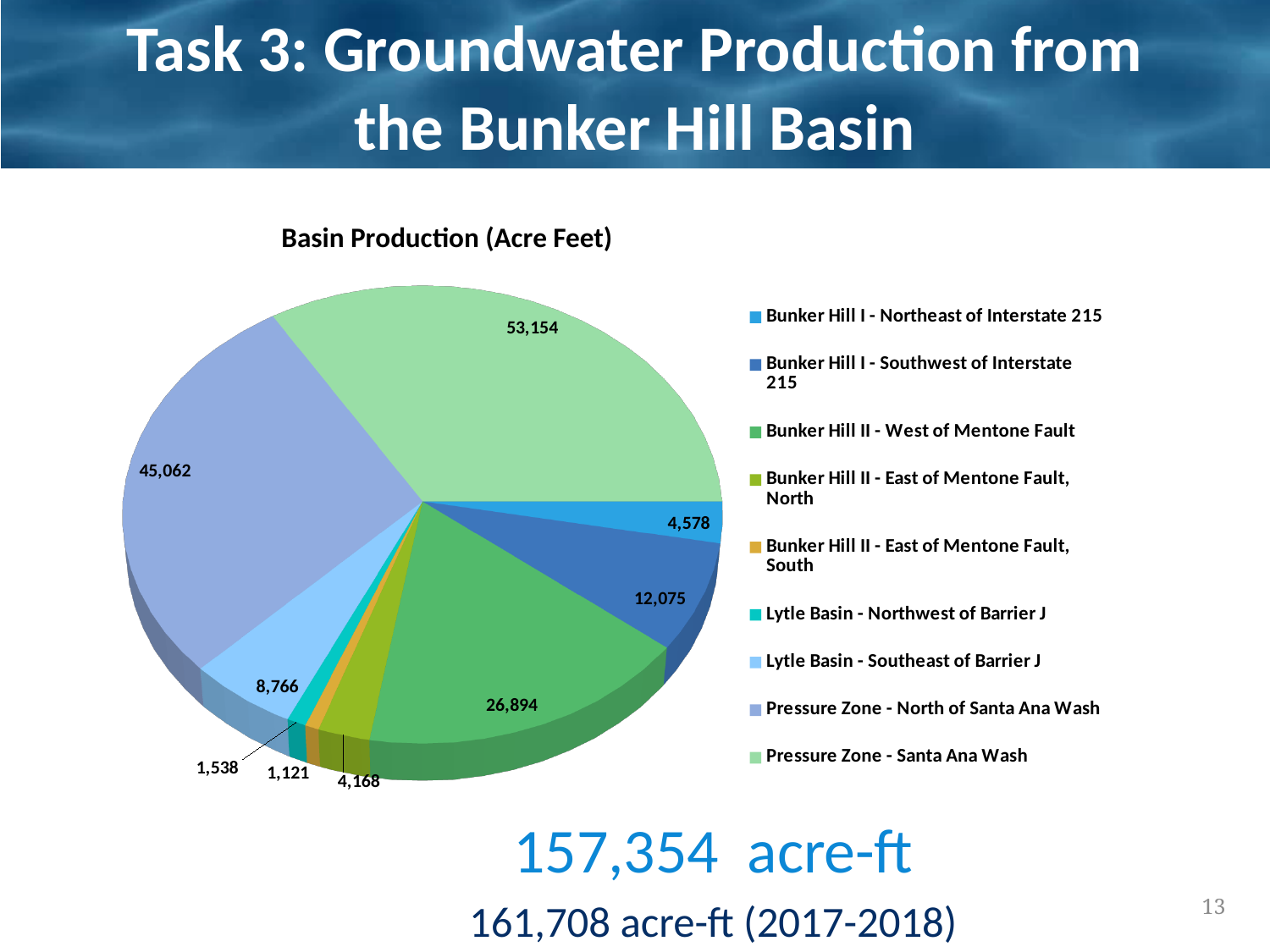
Which is larger: Bunker Hill I - Northeast of Interstate 215 or Bunker Hill II - East of Mentone Fault, North? Bunker Hill I - Northeast of Interstate 215 What is the value for Bunker Hill II - West of Mentone Fault? 26,894 What is the value for Pressure Zone - Santa Ana Wash in the Basin Production pie chart? 53,154 Which category has the largest slice in the pie chart? Pressure Zone - Santa Ana Wash What kind of chart is shown on the slide? Pie chart What is the difference between the values for Pressure Zone - Santa Ana Wash and Pressure Zone - North of Santa Ana Wash? 8,092 What is the title of the chart? Basin Production (Acre Feet) What is the value for Lytle Basin - Southeast of Barrier J? 8,766 How much larger is the value for Bunker Hill I - Southwest of Interstate 215 than for Bunker Hill I - Northeast of Interstate 215? 7,497 How many slices does the pie chart have? 9 Which category has the smallest slice in the pie chart? Bunker Hill II - East of Mentone Fault, South What is the value for Bunker Hill I - Southwest of Interstate 215? 12,075